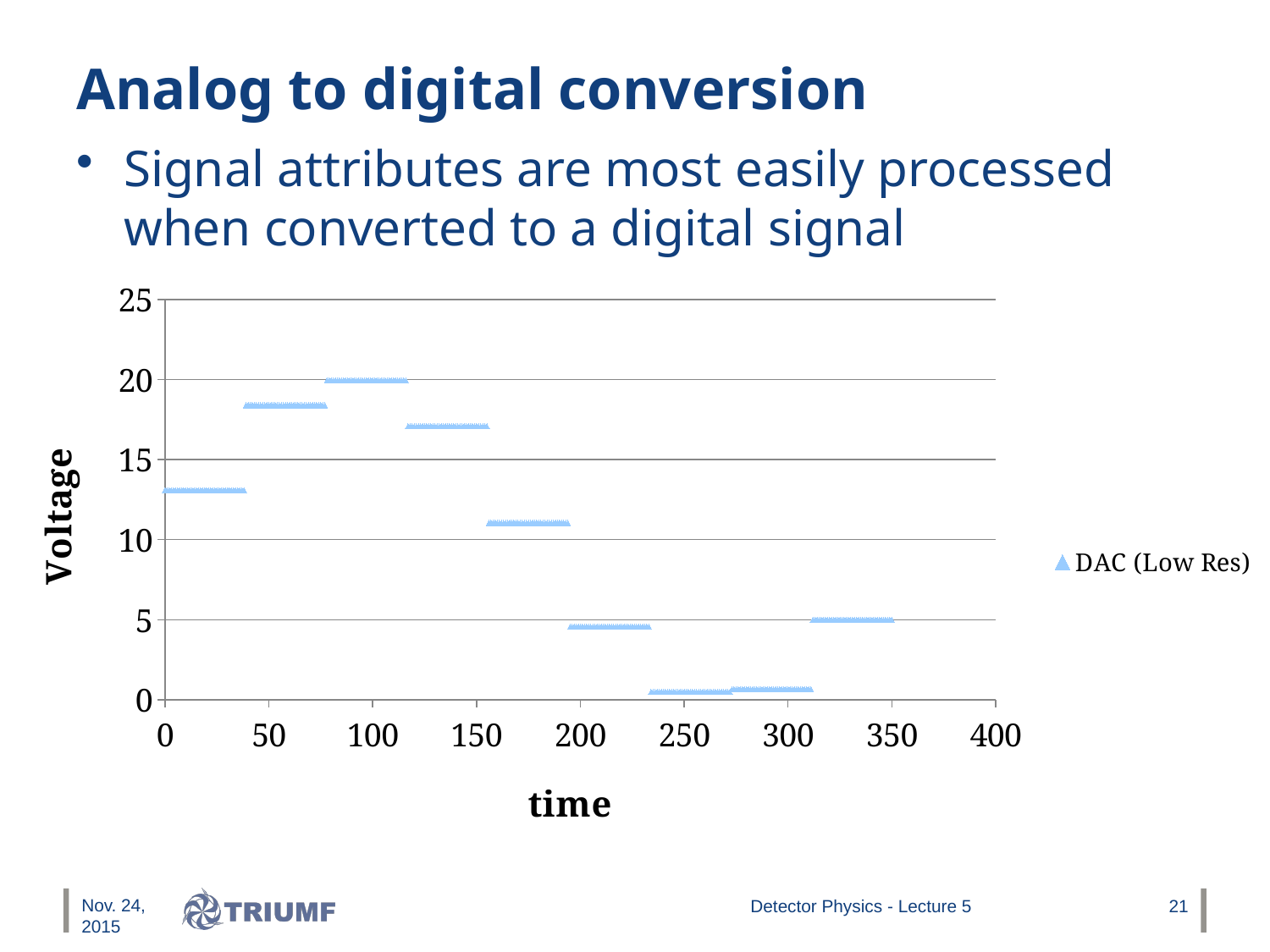
Is the voltage value at time 20 greater or less than 10? greater Is the voltage value at time 60 greater or less than 15? greater What kind of chart is shown on the slide? scatter chart Is the voltage value at time 175 greater or less than 15? less What is the name of the series shown in the chart legend? DAC (Low Res) Which is larger, the voltage at time 100 or the voltage at time 300? time 100 Which is larger, the voltage at time 20 or the voltage at time 330? time 20 How many series does the chart legend list? 1 What is the label of the vertical axis of the chart? Voltage